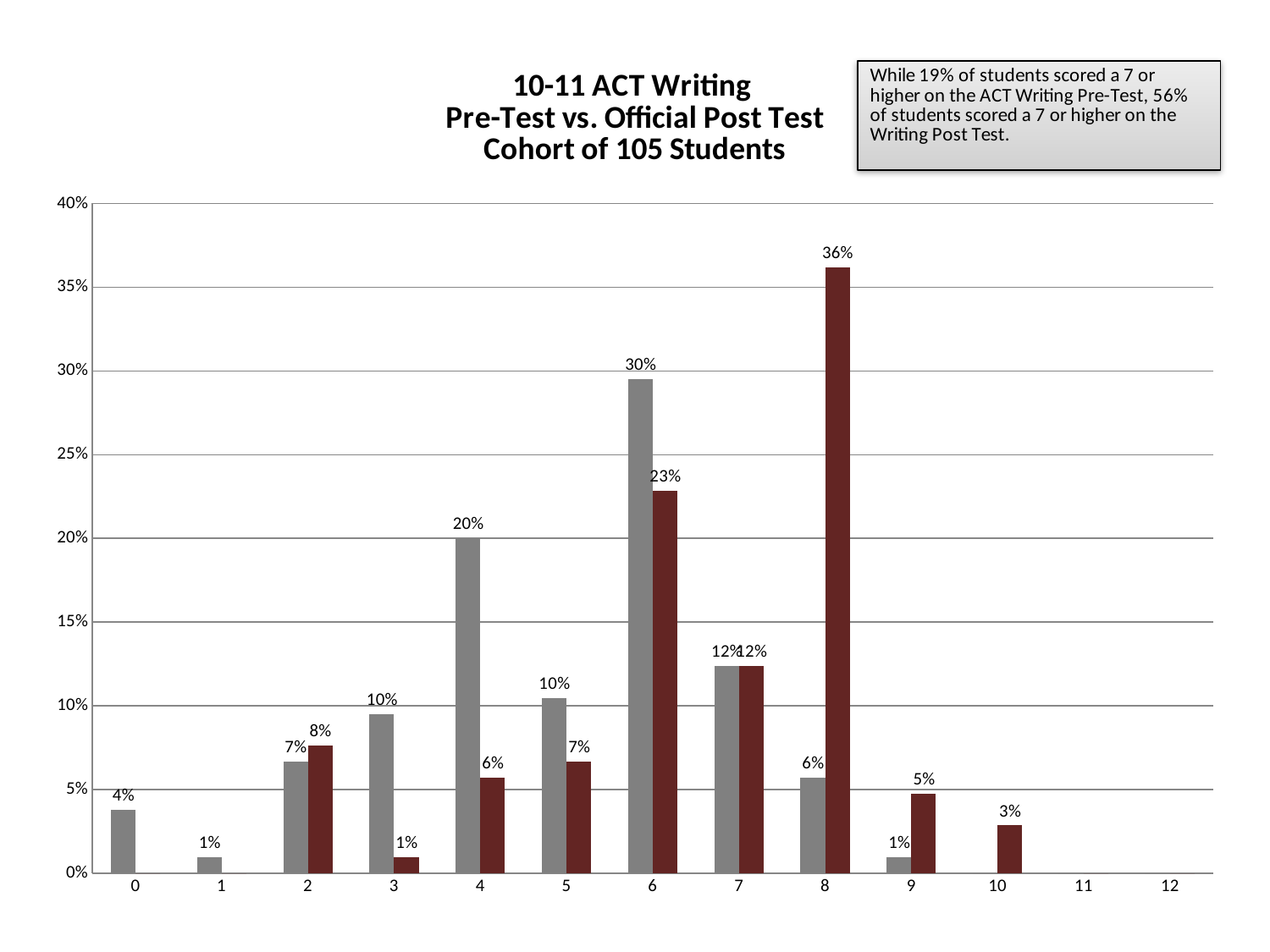
What is the value of the gray bar for score 4? 20% Is the value of the dark red bar for score 8 greater or less than 35%? greater How many score categories are shown on the x axis? 13 Which score has the tallest gray bar? 6 What kind of chart is shown on the slide? bar chart What is the value of the dark red bar for score 8? 36% What is the difference between the gray bar and the dark red bar at score 6? 7% What is the value of the gray bar for score 6? 30% What is the value of the dark red bar for score 10? 3% What is the title of the chart? 10-11 ACT Writing Pre-Test vs. Official Post Test Cohort of 105 Students Which score has the tallest dark red bar? 8 At score 3, which bar is larger, the gray bar or the dark red bar? the gray bar